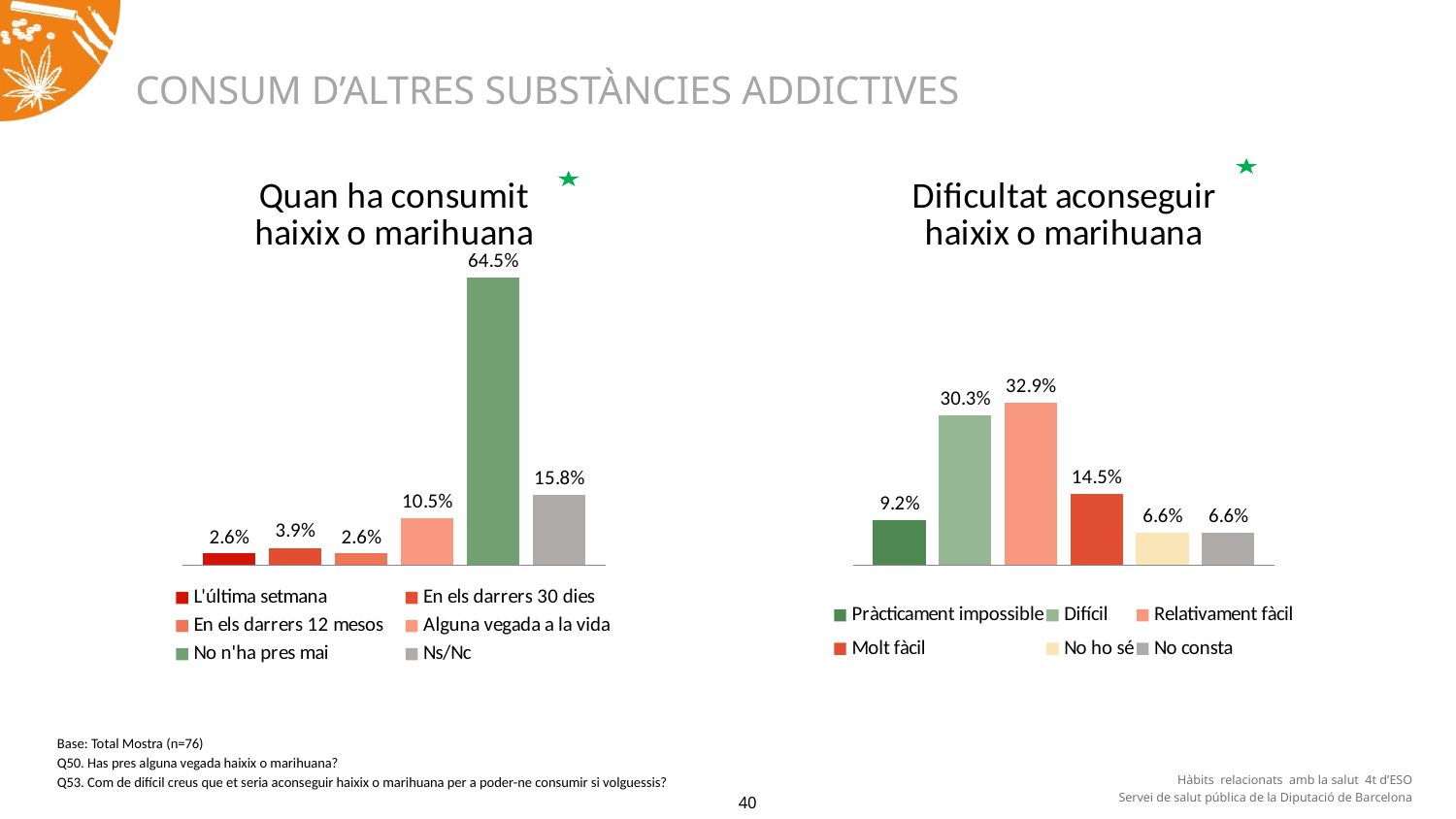
In the 'Dificultat aconseguir haixix o marihuana' chart, what is the value for 'No consta'? 6.6% In the 'Dificultat aconseguir haixix o marihuana' chart, what is the value for 'Relativament fàcil'? 32.9% In the 'Dificultat aconseguir haixix o marihuana' chart, which is larger: 'Difícil' or 'Molt fàcil'? Difícil In the 'Quan ha consumit haixix o marihuana' chart, what is the value for 'No n'ha pres mai'? 64.5% In the 'Dificultat aconseguir haixix o marihuana' chart, how many bars are plotted? 6 In the 'Quan ha consumit haixix o marihuana' chart, what is the difference between 'Ns/Nc' and 'Alguna vegada a la vida'? 5.3% In the 'Dificultat aconseguir haixix o marihuana' chart, what is the difference between 'Relativament fàcil' and 'Difícil'? 2.6% In the 'Quan ha consumit haixix o marihuana' chart, how many series does the legend list? 6 What kind of chart is 'Quan ha consumit haixix o marihuana'? Bar chart In the 'Dificultat aconseguir haixix o marihuana' chart, what is the value for 'Pràcticament impossible'? 9.2% In the 'Quan ha consumit haixix o marihuana' chart, what is the value for 'Alguna vegada a la vida'? 10.5% In the 'Quan ha consumit haixix o marihuana' chart, which category has the highest value? No n'ha pres mai